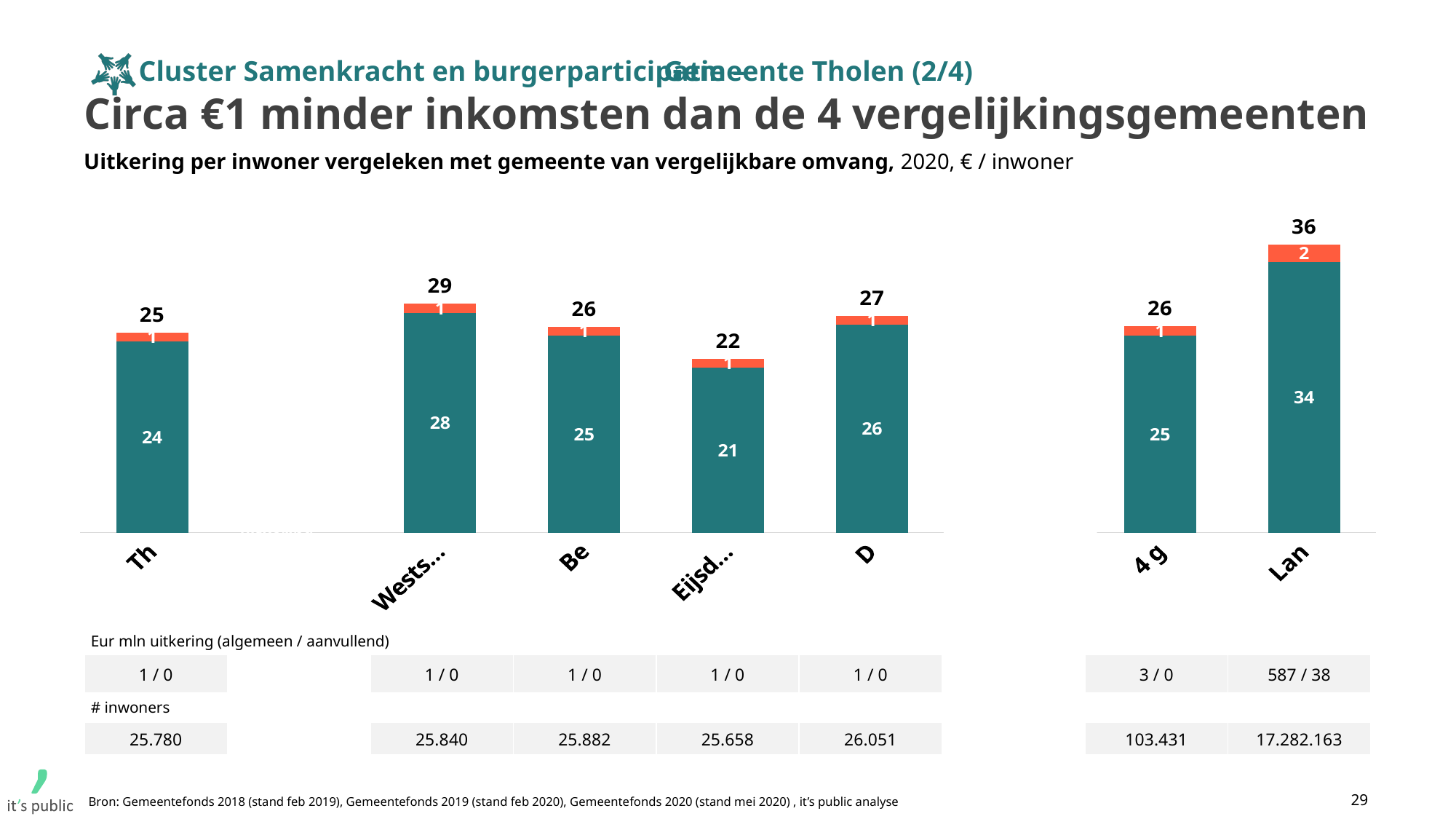
Which bar has the highest total value? Lan What is the total value shown above the bar labelled "4 g"? 26 Which has a larger total, the bar labelled "Wests..." or the bar labelled "D"? Wests... How many bars are plotted in the chart? 7 Which bar has the lowest total value? Eijsd... What kind of chart is shown on the slide? Stacked bar chart What is the difference between the total for "Lan" and the total for "Th"? 11 What is the value of the teal (bottom) segment of the bar labelled "Wests..."? 28 What is the total value shown above the bar labelled "Th"? 25 What is the value of the orange (top) segment of the bar labelled "Lan"? 2 What is the total value shown above the bar labelled "Lan"? 36 What is the value of the teal (bottom) segment of the bar labelled "Eijsd..."? 21